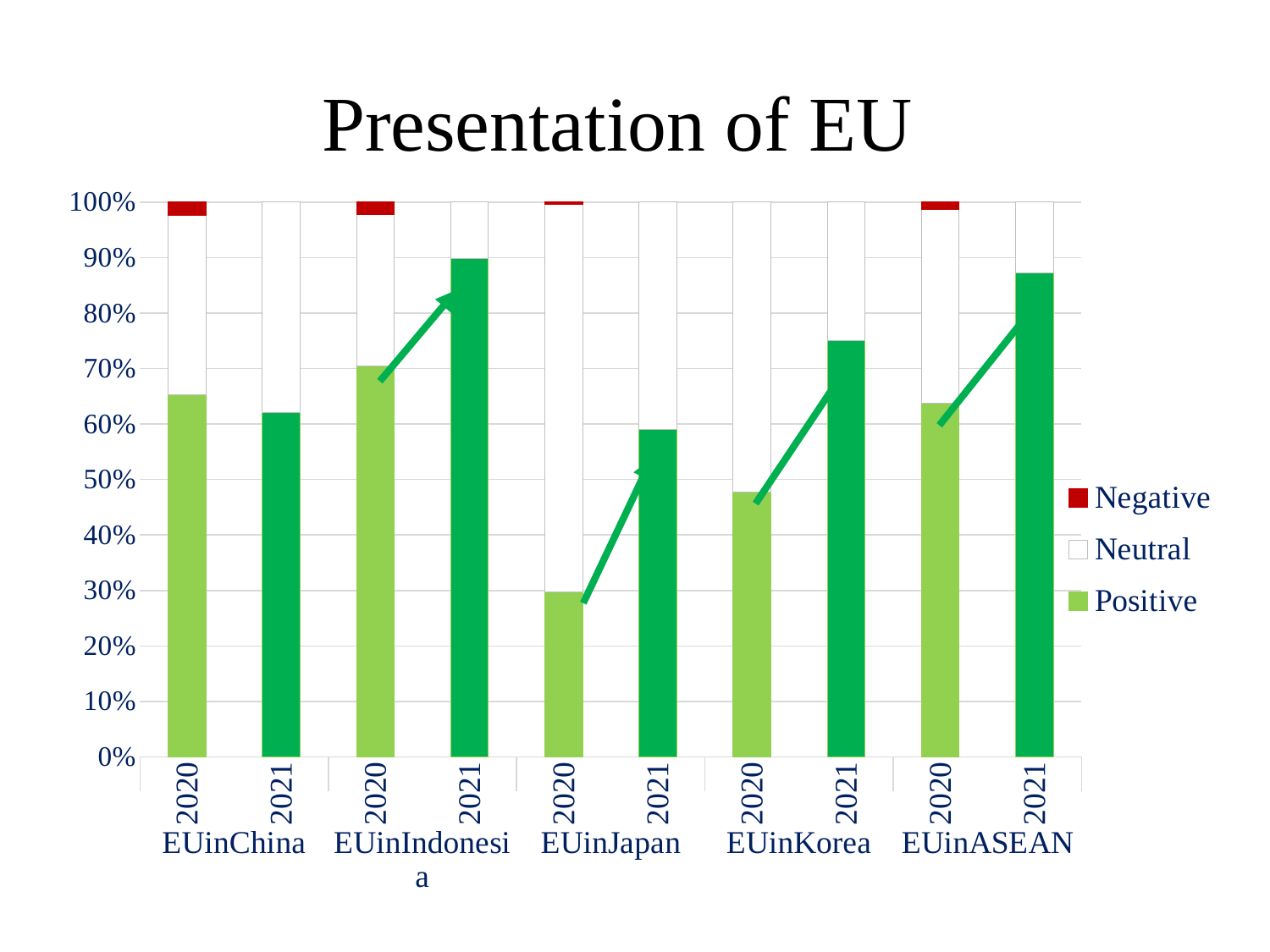
For EUinASEAN, which year has the larger Positive share, 2020 or 2021? 2021 Is the Positive share for EUinKorea in 2021 greater or less than 70%? greater What kind of chart is shown on the slide? Stacked bar chart For EUinJapan, which year has the larger Positive share, 2020 or 2021? 2021 How many country/region groups are shown on the x axis? 5 Is the Positive share for EUinJapan in 2020 greater or less than 40%? less What are the three series listed in the legend? Negative, Neutral, Positive How many series does the legend list? 3 What is the title of the chart? Presentation of EU Which bar has the lowest Positive share? EUinJapan 2020 Is the Positive share for EUinKorea in 2020 greater or less than 60%? less